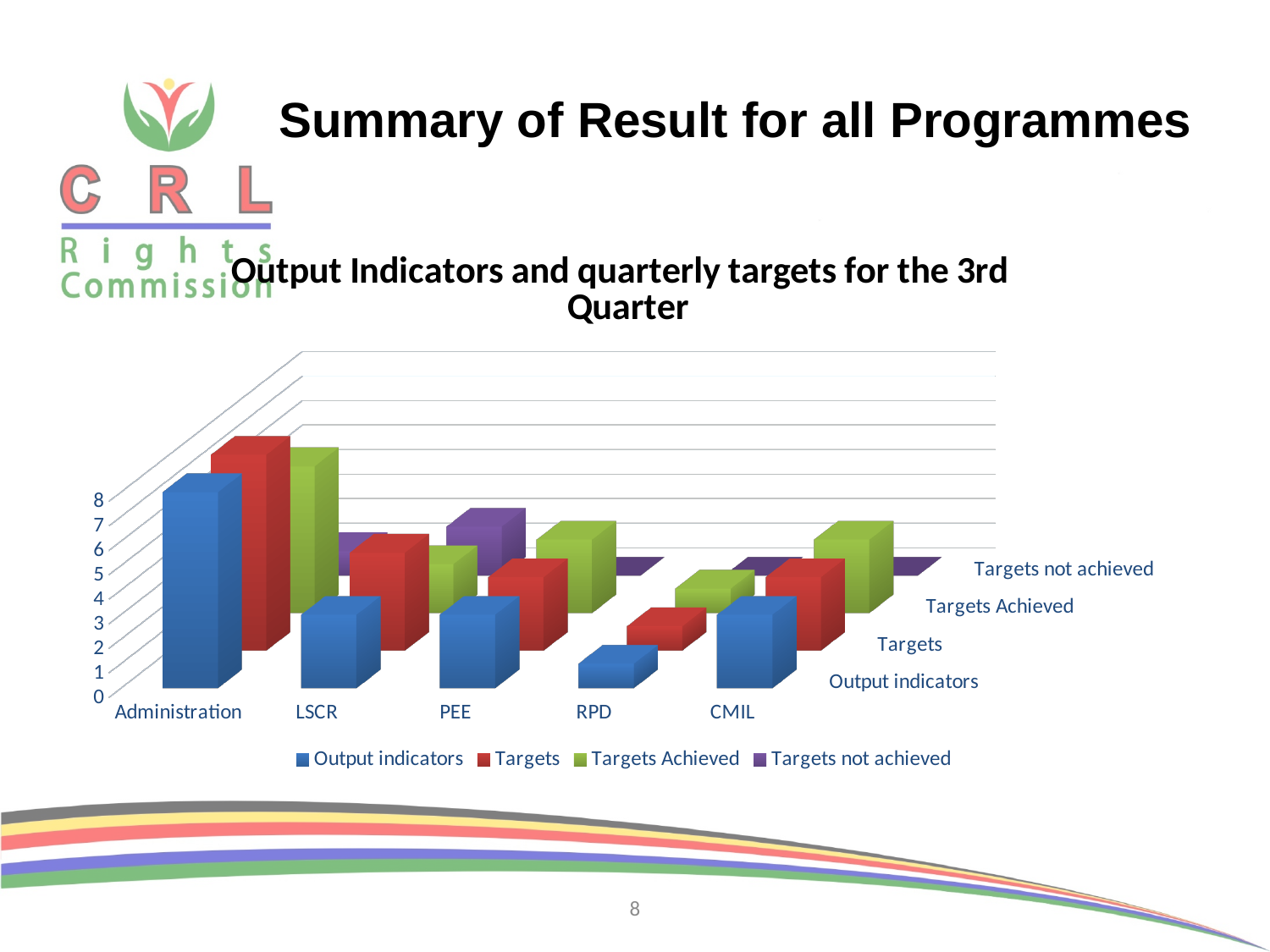
How many series does the chart legend list? 4 Is the Targets value for RPD greater or less than 6? less Which programme has the lowest Output indicators value? RPD Which is larger, the Output indicators value for Administration or for LSCR? Administration Which programme has the highest Output indicators value? Administration What is the title of the chart? Output Indicators and quarterly targets for the 3rd Quarter What kind of chart is shown on the slide? bar chart Is the Output indicators value for Administration greater or less than 4? greater Is the Output indicators value for RPD greater or less than 4? less Which is larger, the Targets value for Administration or for RPD? Administration Which colour represents the Targets series in the chart? red How many programme categories are shown on the x axis of the chart? 5